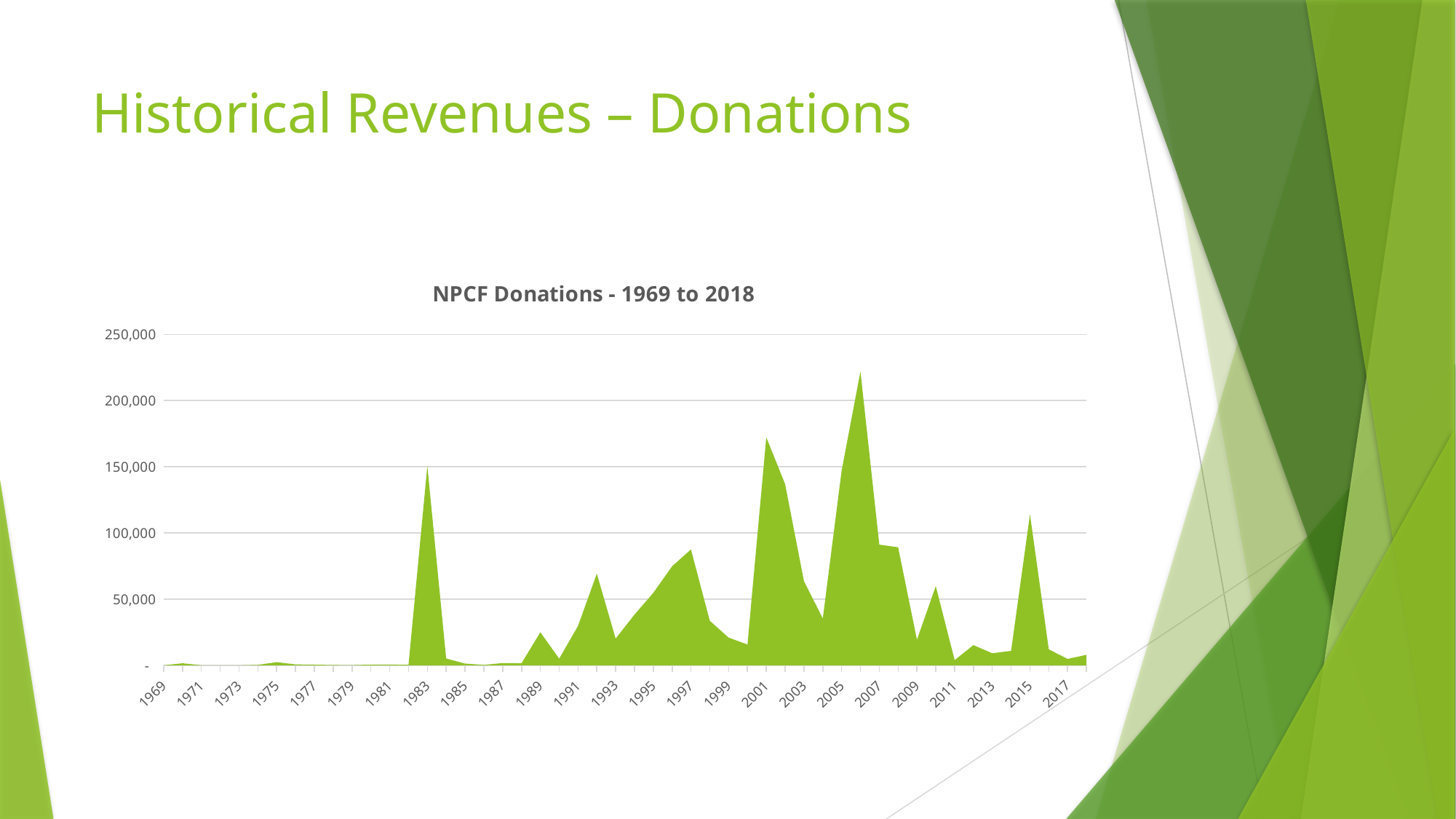
Is the value for 1997 greater or less than 100,000? less What is the title of the chart? NPCF Donations - 1969 to 2018 Which year has the larger donation value, 2001 or 2015? 2001 Is the value for 2001 greater or less than 150,000? greater Is the value for 1992 greater or less than 50,000? greater Do donations rise or fall between 2006 and 2009? Fall In which year do donations reach their highest value? 2006 Which year has the larger donation value, 2006 or 1983? 2006 Do donations rise or fall between 1993 and 1997? Rise What kind of chart is shown on the slide? Area chart